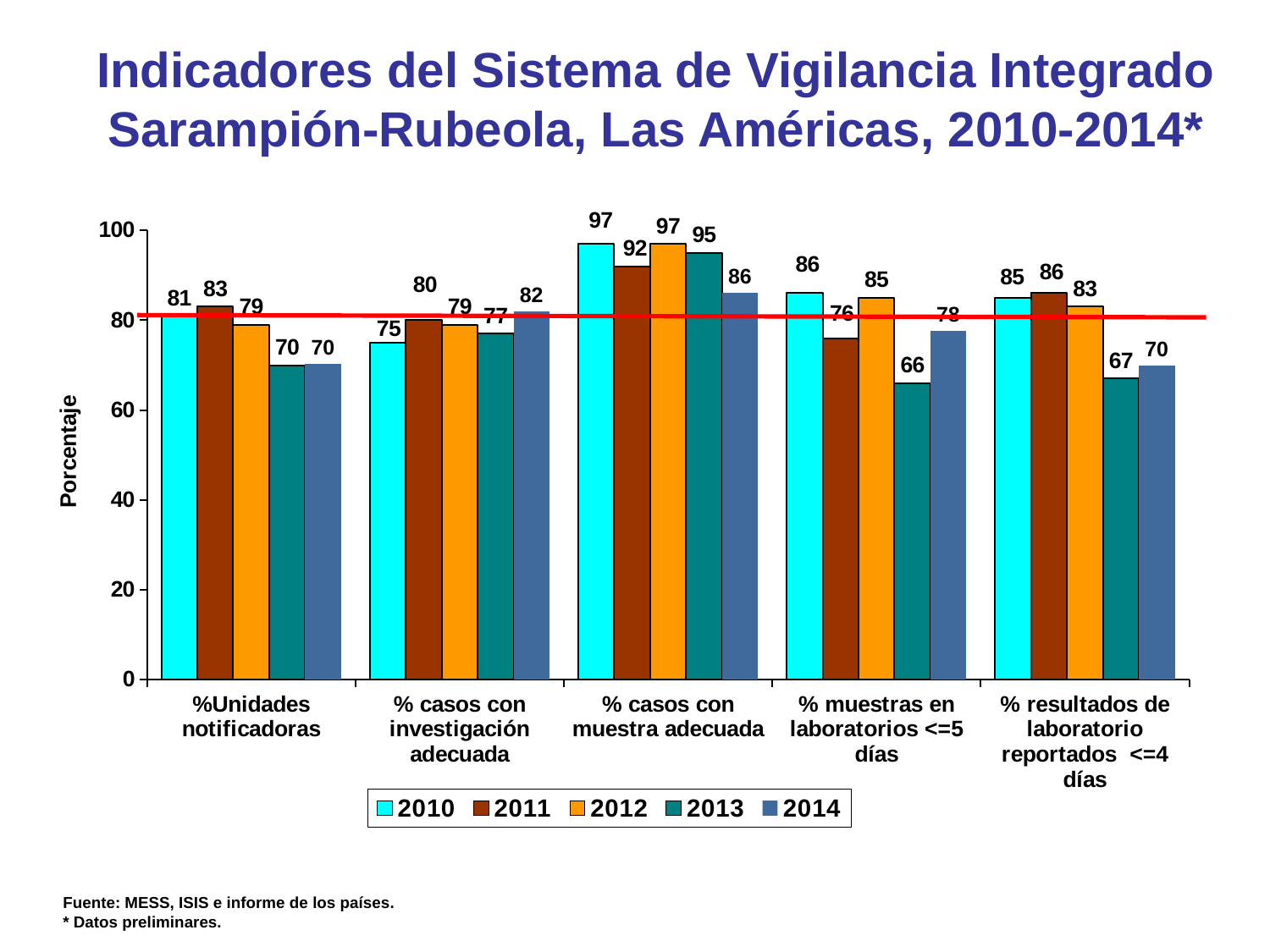
Which is larger: the 2012 value for "% casos con muestra adecuada" or the 2012 value for "% muestras en laboratorios <=5 días"? % casos con muestra adecuada What is the value for 2014 in the "% casos con investigación adecuada" category? 82 What kind of chart is shown on the slide? Bar chart What is the value for 2011 in the "%Unidades notificadoras" category? 83 How many series does the legend list? 5 What is the label of the y axis? Porcentaje How many categories are shown on the x axis? 5 Which year has the highest value in the "% resultados de laboratorio reportados <=4 días" category? 2011 What is the difference between the 2010 and 2013 values in the "% muestras en laboratorios <=5 días" category? 20 Which year has the lowest value in the "% casos con muestra adecuada" category? 2014 What is the value for 2013 in the "% muestras en laboratorios <=5 días" category? 66 Is the 2013 value for "% resultados de laboratorio reportados <=4 días" greater or less than 80? less